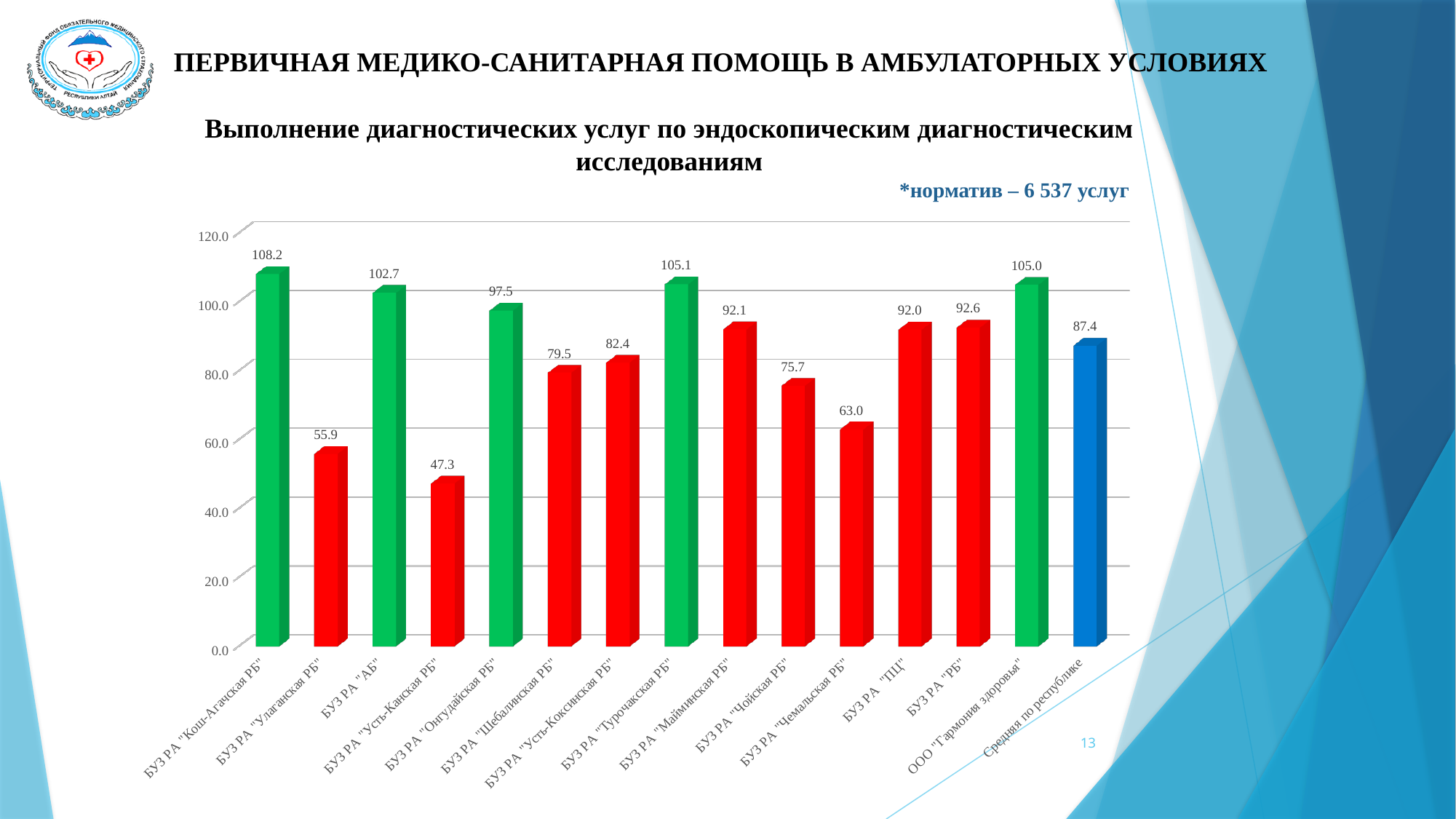
Which category has the lowest value? БУЗ РА "Усть-Канская РБ" What norm (норматив) is stated above the chart? 6 537 услуг What is the value for БУЗ РА "Кош-Агачская РБ"? 108.2 How many categories are shown on the x axis of the chart? 15 Is the value for БУЗ РА "Шебалинская РБ" greater or less than 80.0? less What is the value for Средняя по республике? 87.4 What is the value for БУЗ РА "Усть-Канская РБ"? 47.3 What type of chart is shown on the slide? bar chart What is the difference between the values for БУЗ РА "Кош-Агачская РБ" and БУЗ РА "Усть-Канская РБ"? 60.9 Which is larger, the value for БУЗ РА "Улаганская РБ" or БУЗ РА "Чемальская РБ"? БУЗ РА "Чемальская РБ" Which category has the highest value? БУЗ РА "Кош-Агачская РБ" What is the value for ООО "Гармония здоровья"? 105.0